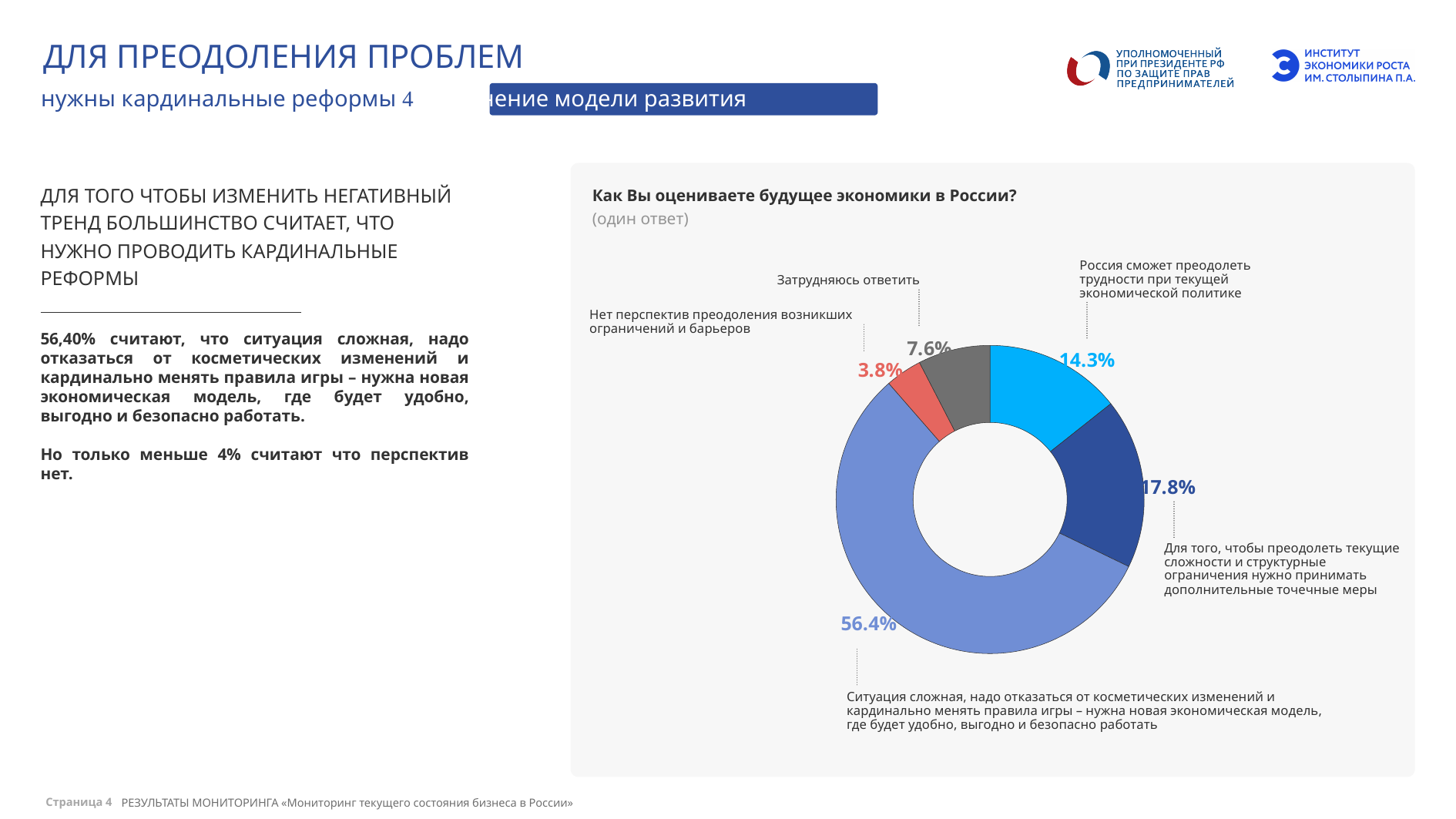
Как звучит вопрос, результаты которого показаны на диаграмме? Как Вы оцениваете будущее экономики в России? Какая доля респондентов считает, что нужно принимать дополнительные точечные меры? 17.8% Какой тип диаграммы показан на слайде? Кольцевая (круговая) диаграмма Какой вариант ответа набрал наибольшую долю? Ситуация сложная, надо отказаться от косметических изменений и кардинально менять правила игры – нужна новая экономическая модель Какая доля респондентов считает, что Россия сможет преодолеть трудности при текущей экономической политике? 14.3% Какая доля респондентов ответила «Ситуация сложная, надо отказаться от косметических изменений и кардинально менять правила игры»? 56.4% Сколько вариантов ответа (сегментов) показано на диаграмме? 5 Какая доля респондентов считает, что нет перспектив преодоления возникших ограничений и барьеров? 3.8% Что больше: доля ответа «Затрудняюсь ответить» или доля ответа «Нет перспектив преодоления возникших ограничений и барьеров»? Затрудняюсь ответить На сколько процентных пунктов доля ответа «дополнительные точечные меры» (17.8%) больше доли ответа «Россия сможет преодолеть трудности при текущей экономической политике» (14.3%)? 3.5 Какой вариант ответа набрал наименьшую долю? Нет перспектив преодоления возникших ограничений и барьеров Какая доля респондентов ответила «Затрудняюсь ответить»? 7.6%